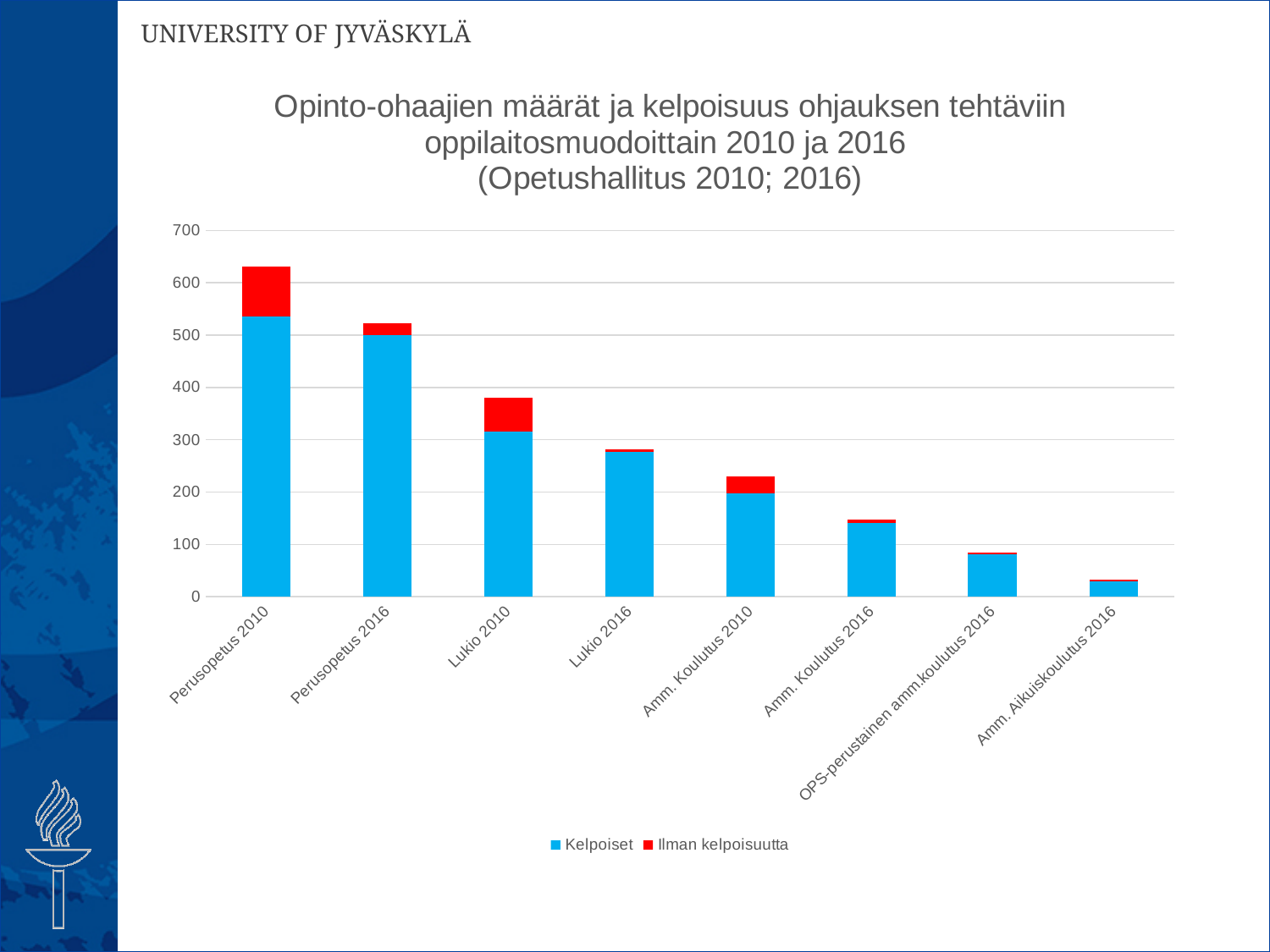
Which colour represents the series Ilman kelpoisuutta in the legend? Red Is the total bar for OPS-perustainen amm.koulutus 2016 greater or less than 100? less Is the total bar for Perusopetus 2010 greater or less than 600? greater How many series does the legend list? 2 How many categories are shown on the x axis of the chart? 8 What kind of chart is shown on the slide? Stacked bar chart Which category has the tallest stacked bar? Perusopetus 2010 Is the total bar for Amm. Koulutus 2016 greater or less than 100? greater Which category has the shortest stacked bar? Amm. Aikuiskoulutus 2016 Do the stacked bar totals rise or fall from left to right along the x axis? fall Which is larger, the total bar for Lukio 2010 or for Lukio 2016? Lukio 2010